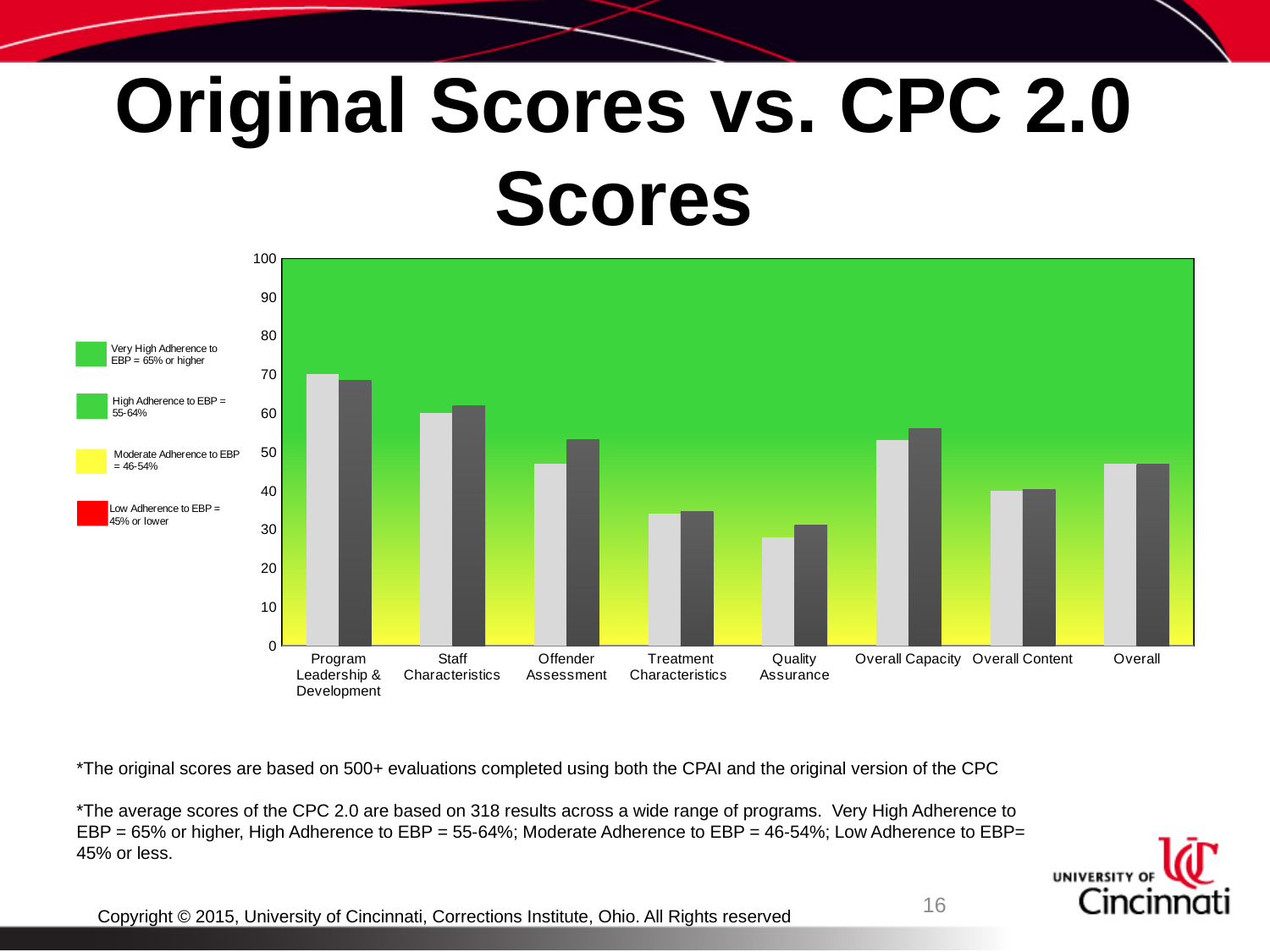
Which is larger for Offender Assessment, the light gray bar or the dark gray bar? the dark gray bar Is the light gray bar for Program Leadership & Development greater or less than 60? greater What kind of chart is shown on the slide? bar chart What is the title of the slide containing the chart? Original Scores vs. CPC 2.0 Scores How many bars are plotted for each category in the chart? 2 Which category has a larger light gray bar, Staff Characteristics or Treatment Characteristics? Staff Characteristics Is the dark gray bar for Overall Capacity greater or less than 50? greater Is the dark gray bar for Treatment Characteristics greater or less than 40? less How many categories are shown along the x axis of the chart? 8 Which category has the lowest bars in the chart? Quality Assurance Which category has the highest bars in the chart? Program Leadership & Development